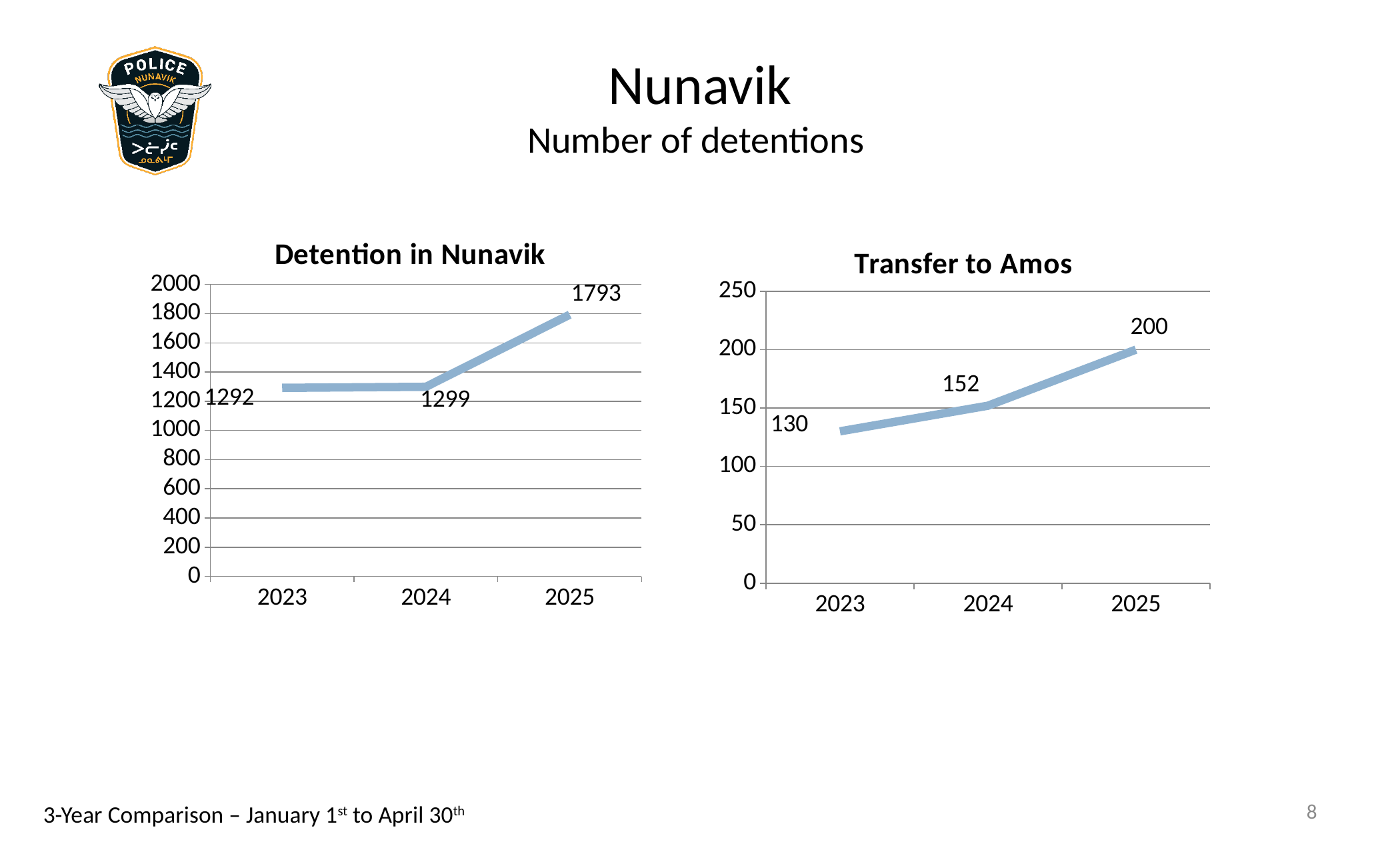
In the 'Transfer to Amos' chart, which year has the lowest value? 2023 How many years are plotted in the 'Transfer to Amos' chart? 3 In the 'Transfer to Amos' chart, what is the difference between the 2025 and 2023 values? 70 In the 'Detention in Nunavik' chart, which year has the highest value? 2025 What kind of chart is 'Detention in Nunavik'? Line chart In the 'Detention in Nunavik' chart, what is the difference between the 2025 and 2024 values? 494 In the 'Detention in Nunavik' chart, what is the value for 2025? 1793 In the 'Transfer to Amos' chart, what is the value for 2024? 152 In the 'Transfer to Amos' chart, do the values rise or fall from 2023 to 2025? Rise In the 'Detention in Nunavik' chart, what is the value for 2023? 1292 In the 'Detention in Nunavik' chart, is the value for 2025 greater or less than 1600? greater In the 'Transfer to Amos' chart, is the value for 2025 larger than the value for 2024? Yes